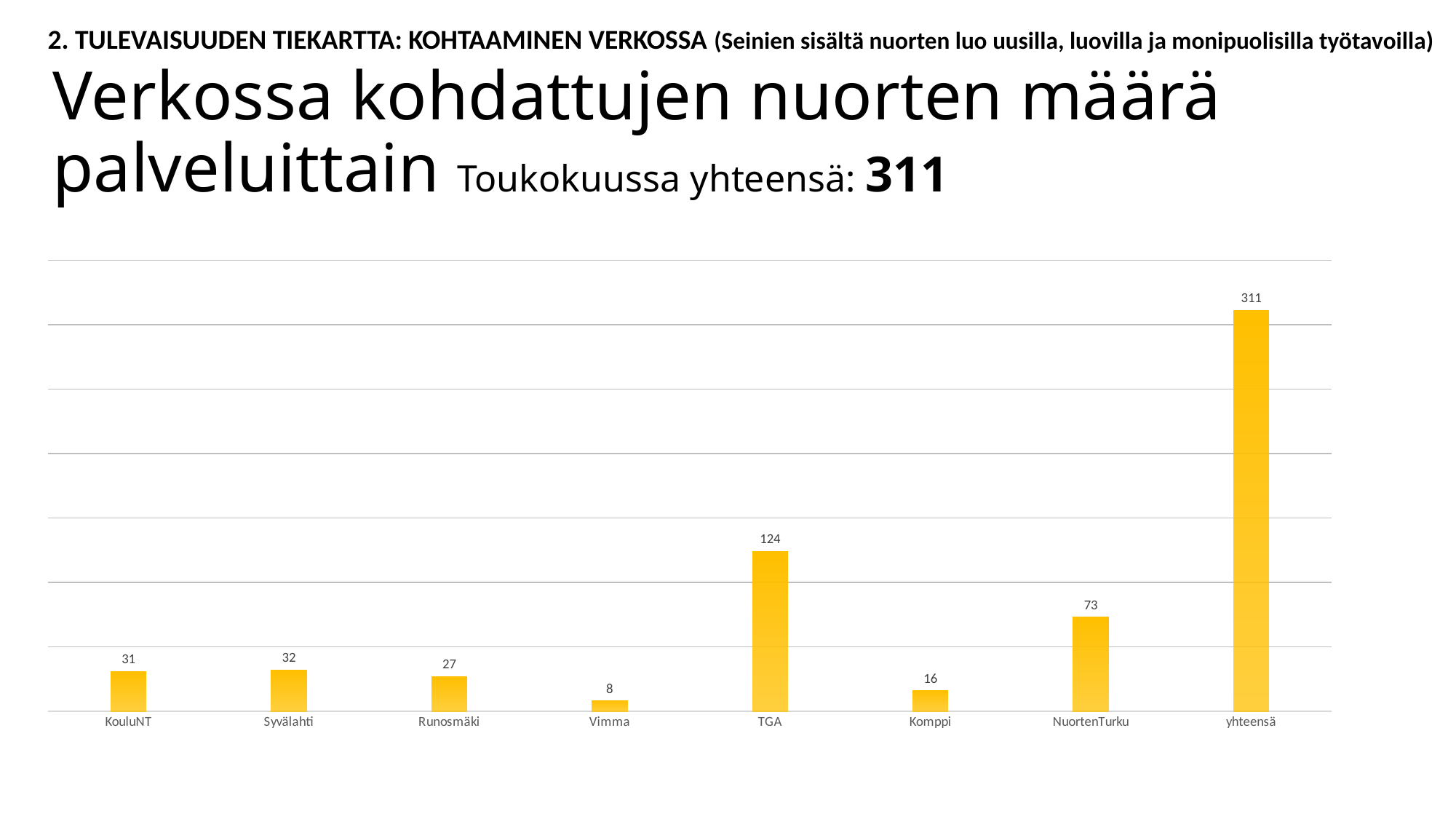
What kind of chart is shown on the slide? Bar chart What is the difference between the values for TGA and NuortenTurku? 51 What is the value for NuortenTurku? 73 Which is larger, the value for KouluNT or the value for Komppi? KouluNT What is the value for Vimma? 8 Excluding the yhteensä total bar, which service has the highest value? TGA What is the value for TGA? 124 Which category has the lowest value? Vimma How many bars are shown in the chart? 8 What is the value for Komppi? 16 What total for May (Toukokuussa yhteensä) is stated in the slide title? 311 What is the difference between the values for Syvälahti and Runosmäki? 5